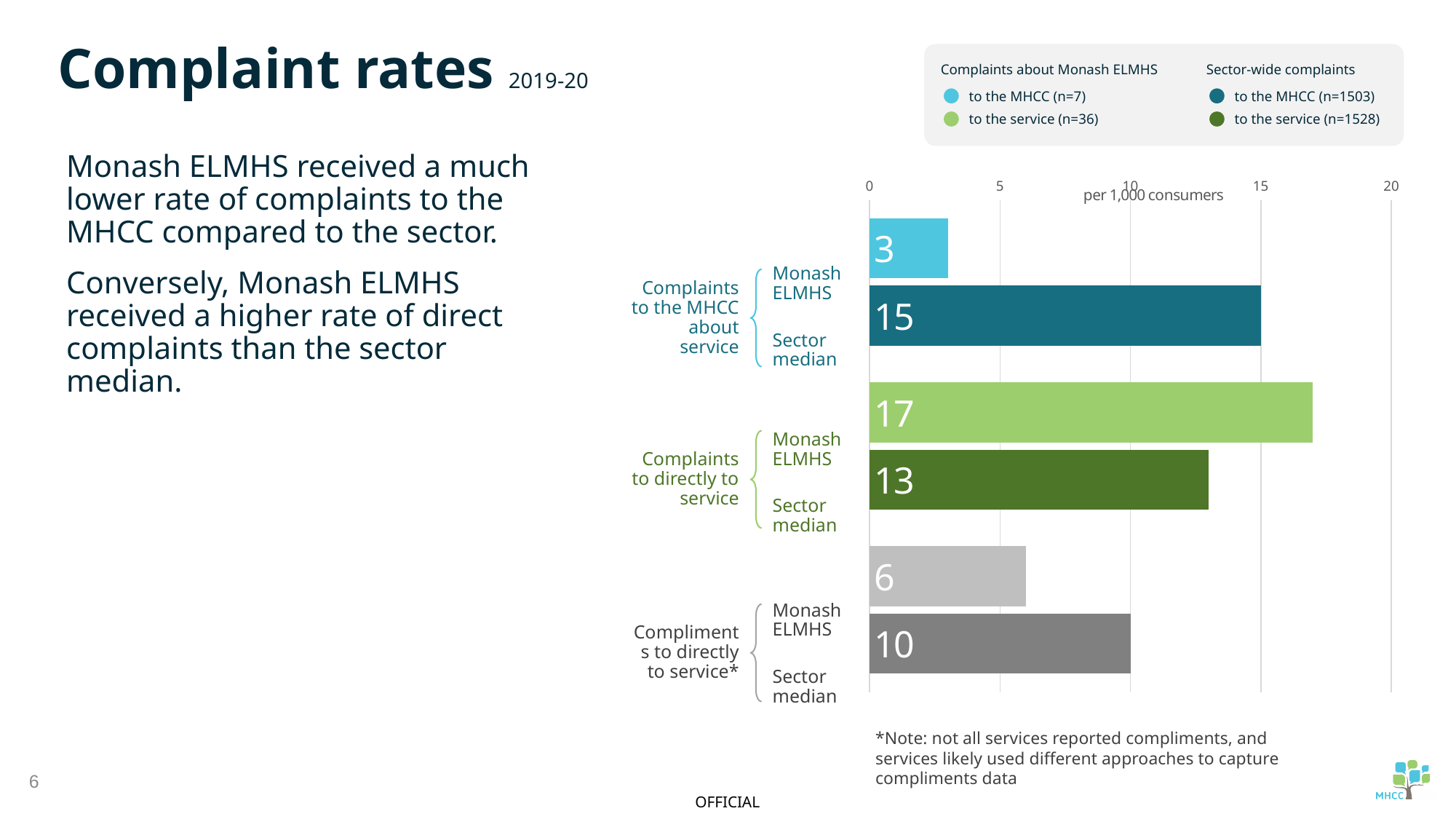
For compliments directly to service, which is larger: Monash ELMHS or the sector median? Sector median Which bar in the chart has the highest value? Monash ELMHS complaints directly to service (17) What is the rate of complaints to the MHCC about service for Monash ELMHS, per 1,000 consumers? 3 According to the legend, how many sector-wide complaints to the MHCC were there (n)? 1503 What is the sector median rate of compliments made directly to the service, per 1,000 consumers? 10 What type of chart is shown on the slide? Bar chart What is the difference between the sector median and Monash ELMHS rates of complaints to the MHCC about service? 12 What is the rate of complaints made directly to the service for Monash ELMHS, per 1,000 consumers? 17 What is the sector median rate of complaints to the MHCC about service, per 1,000 consumers? 15 Which bar in the chart has the lowest value? Monash ELMHS complaints to the MHCC about service (3) Is the Monash ELMHS rate of complaints directly to service greater or less than 15? greater What is the difference between the Monash ELMHS and sector median rates of complaints made directly to the service? 4